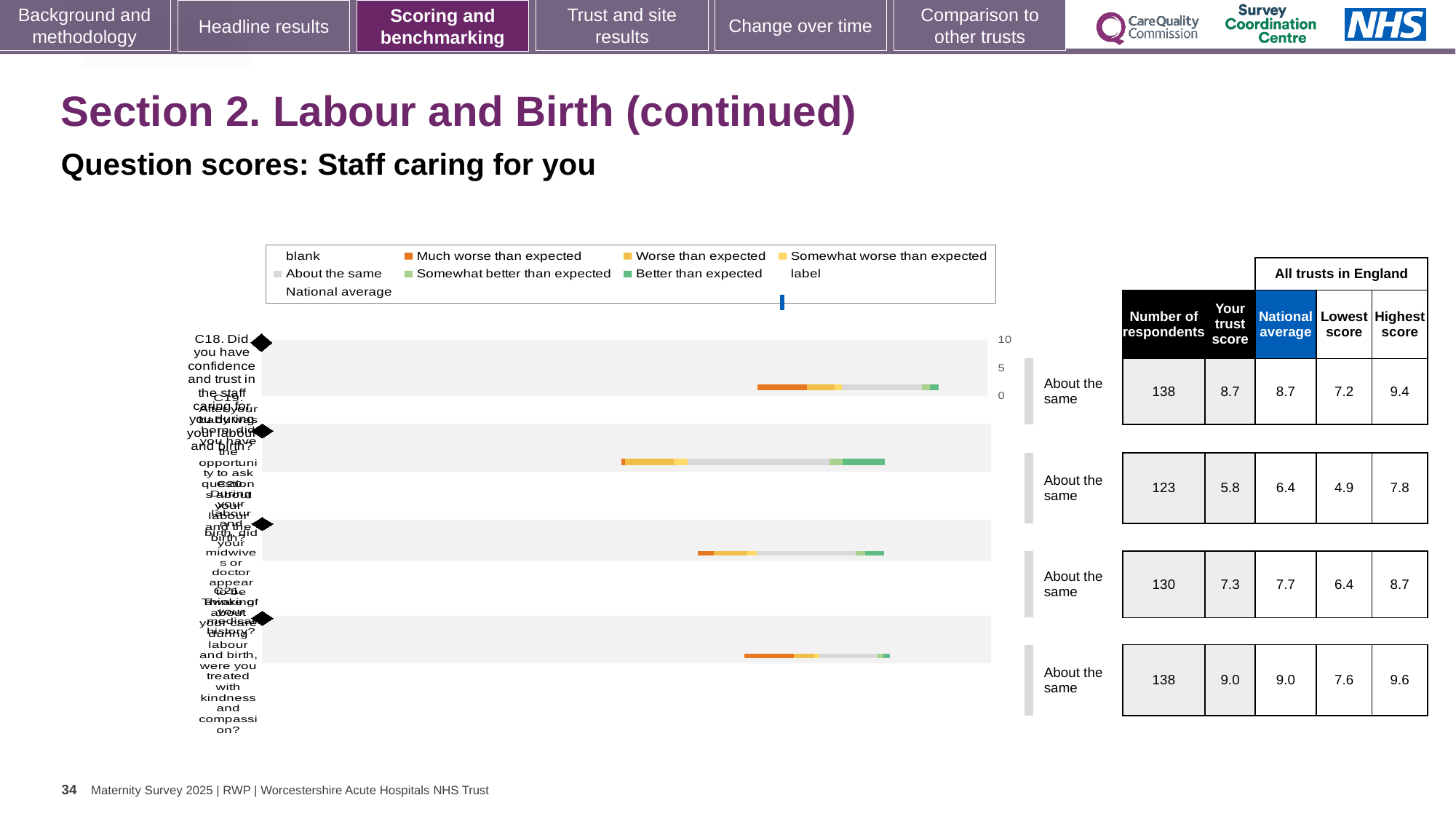
Which question has the highest trust score in the table beside the chart? C21 In the table beside the chart, what is the lowest score for question C19? 4.9 In the table beside the chart, what is the highest score for question C21? 9.6 In the table beside the chart, what is the national average for question C20? 7.7 Which question has the lowest trust score in the table beside the chart? C19 What kind of chart is shown on the slide? bar chart Which has the larger trust score, question C18 or question C20? C18 What benchmark category is shown for question C20 next to the chart? About the same In the table beside the chart, what is the number of respondents for question C18? 138 What is the difference between the national average and the trust score for question C19? 0.6 In the table beside the chart, what is the trust score for question C19? 5.8 How many question bars are plotted in the chart? 4